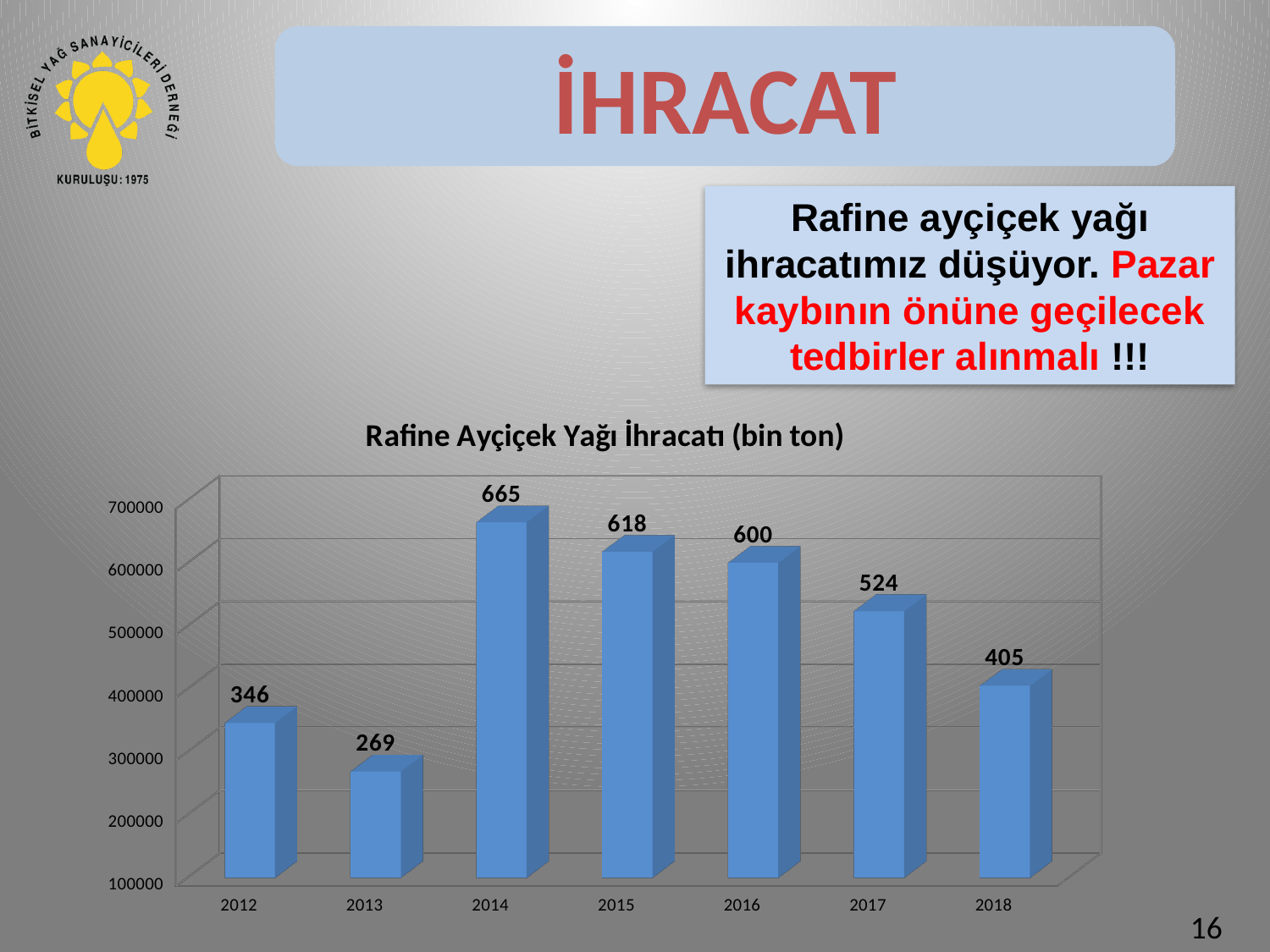
What is the difference between the values for 2012 and 2013? 77 Which is larger, the value for 2015 or the value for 2016? 2015 What is the value for 2013 in the chart? 269 How many years are shown on the x axis of the chart? 7 What is the difference between the values for 2014 and 2018? 260 What is the value for 2018 in the chart? 405 What is the value for 2014 in the chart? 665 Which year has the highest value in the chart? 2014 What is the title of the chart? Rafine Ayçiçek Yağı İhracatı (bin ton) Do the values rise or fall from 2014 to 2018? fall Which year has the lowest value in the chart? 2013 What kind of chart is shown on the slide? bar chart